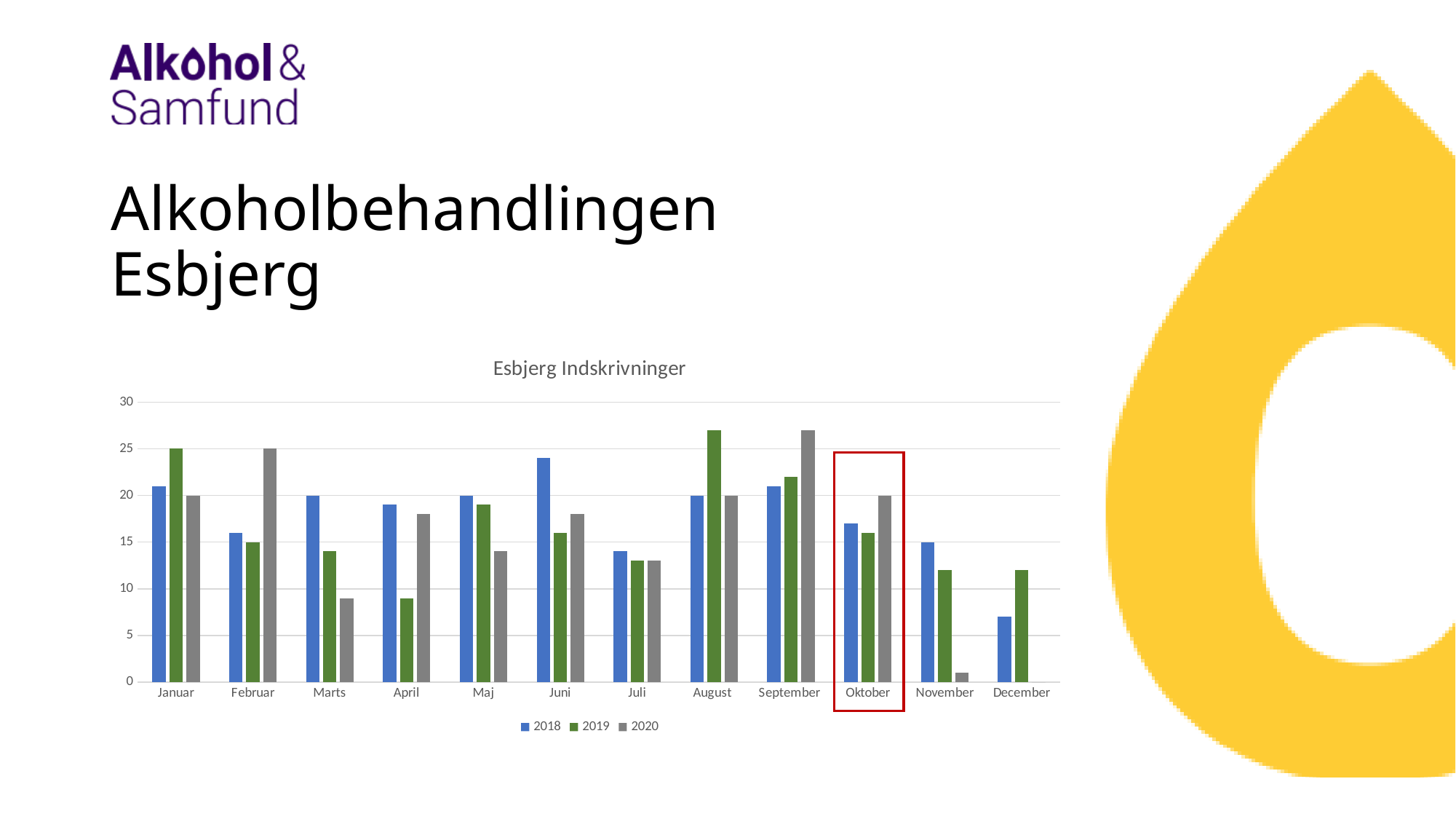
Which series has the lowest bar in November? 2020 What is the value for 2018 in November? 15 What is the value for 2019 in Januar? 25 Is the value for 2018 in December greater or less than 10? less What is the title of the chart? Esbjerg Indskrivninger Is the value for 2018 in Juni greater or less than 20? greater Which month is highlighted with a red box? Oktober In Juni, which is larger: the value for 2018 or the value for 2019? 2018 How many series does the legend list? 3 How many months are shown on the x axis? 12 What kind of chart is shown on the slide? bar chart What is the value for 2020 in Februar? 25